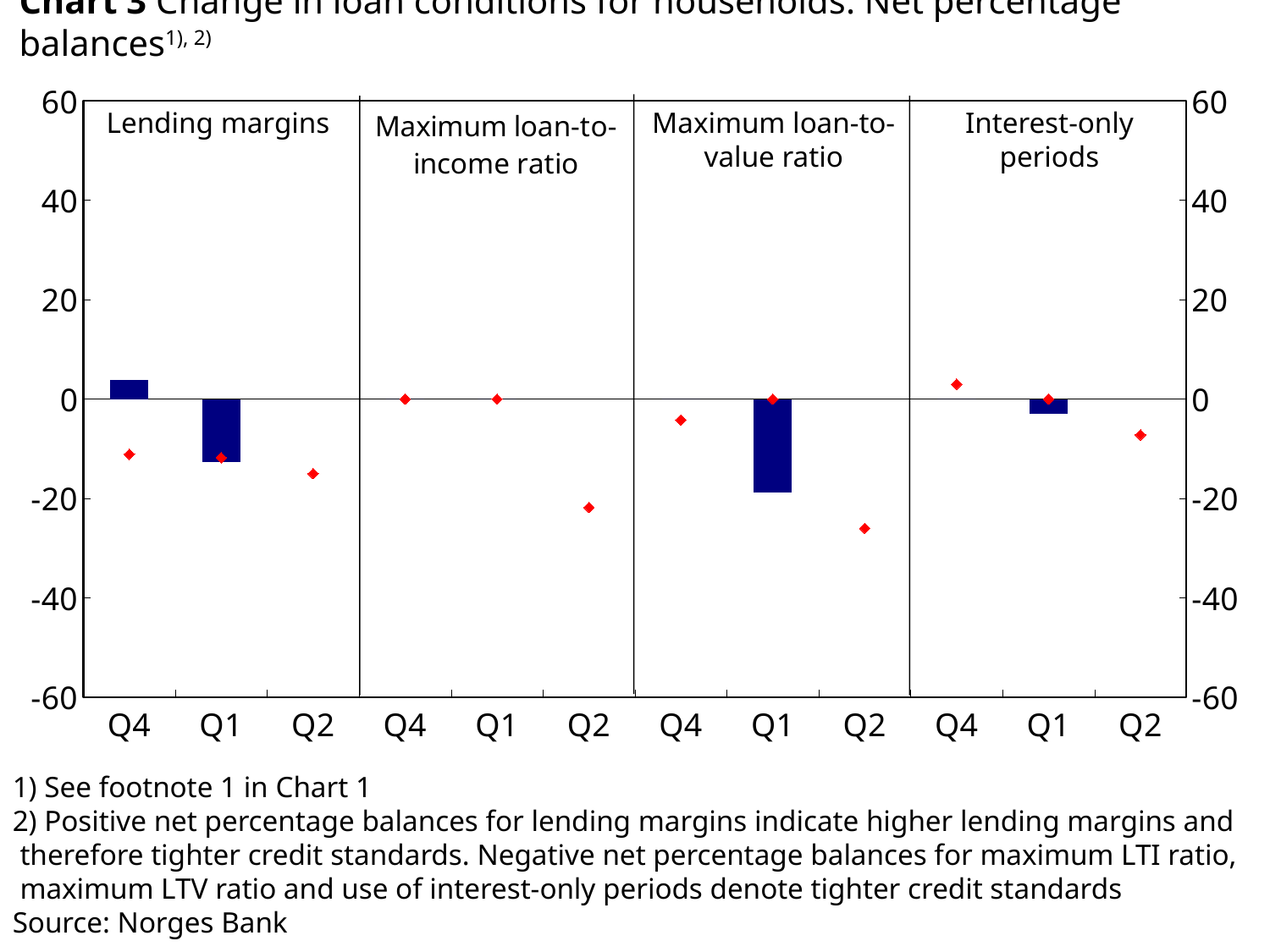
How many quarters are shown on the x axis within each panel? 3 What kind of chart is shown on the slide? combination bar and line chart (bars with diamond markers) Which panel contains the lowest bar in the chart? Maximum loan-to-value ratio Is the Q1 bar value in the Maximum loan-to-value ratio panel greater or less than -10? less Is the Q2 marker value in the Maximum loan-to-income ratio panel greater or less than -20? less Is the Q2 marker value in the Maximum loan-to-value ratio panel greater or less than -20? less Do the marker values in the Interest-only periods panel rise or fall from Q4 to Q2? fall Which is larger: the Q1 bar in the Lending margins panel or the Q1 bar in the Maximum loan-to-value ratio panel? Lending margins How many panels (loan condition categories) does the chart have? 4 What is the maximum value shown on the vertical axis? 60